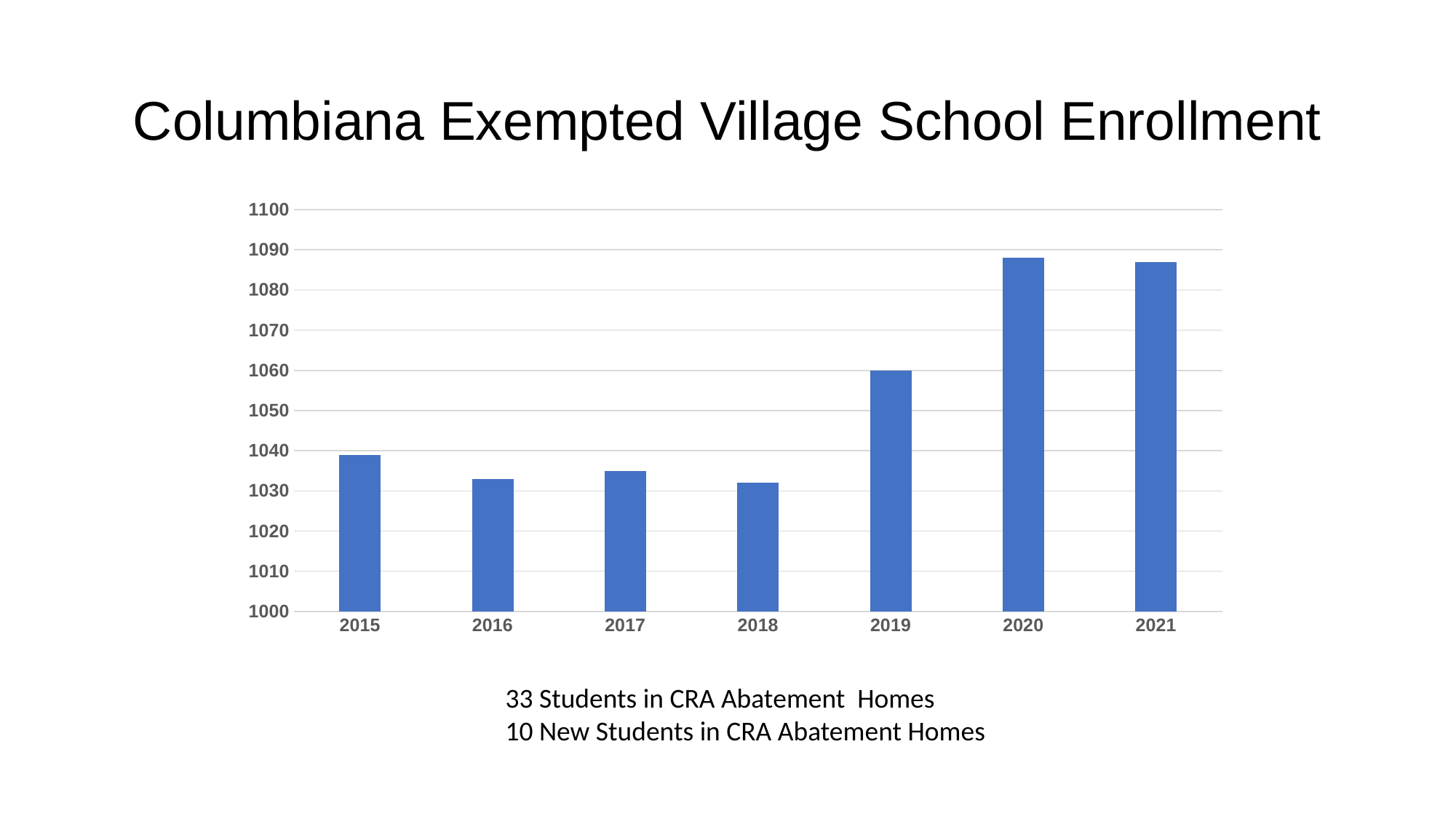
Is the value for 2015 greater or less than 1030? greater Is the value for 2020 greater or less than 1080? greater Which year has the larger enrollment, 2015 or 2020? 2020 What is the enrollment value for 2019? 1060 Overall, does enrollment rise or fall from 2015 to 2021? rise Which year has the larger enrollment, 2017 or 2019? 2019 Is the value for 2018 greater or less than 1040? less How many years are shown on the x axis of the chart? 7 What kind of chart is shown on the slide? bar chart What is the title of the chart? Columbiana Exempted Village School Enrollment